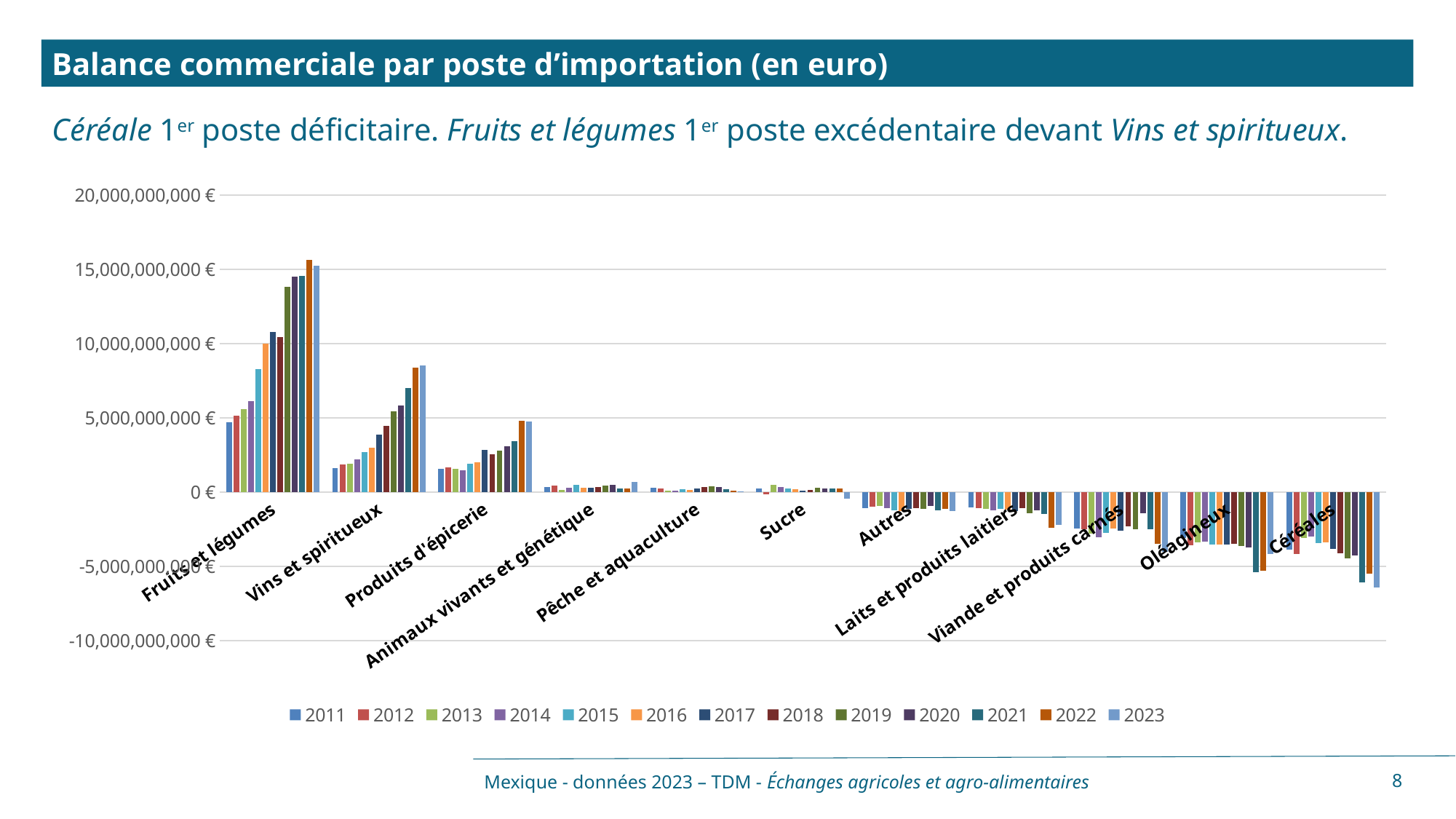
Do the values for Vins et spiritueux generally rise or fall from 2011 to 2023? rise Which category has the lowest (most negative) value in 2023? Céréales What is the title of the chart? Balance commerciale par poste d'importation (en euro) How many series does the legend list? 13 What kind of chart is shown on the slide? bar chart Is the value for Fruits et légumes in 2022 greater or less than 15,000,000,000 €? greater Which category has the highest value in 2023? Fruits et légumes Is the value for Fruits et légumes in 2011 greater or less than 5,000,000,000 €? less Is the value for Vins et spiritueux in 2023 greater or less than 5,000,000,000 €? greater Which is larger in 2023: Vins et spiritueux or Produits d'épicerie? Vins et spiritueux How many import categories are shown on the x axis? 11